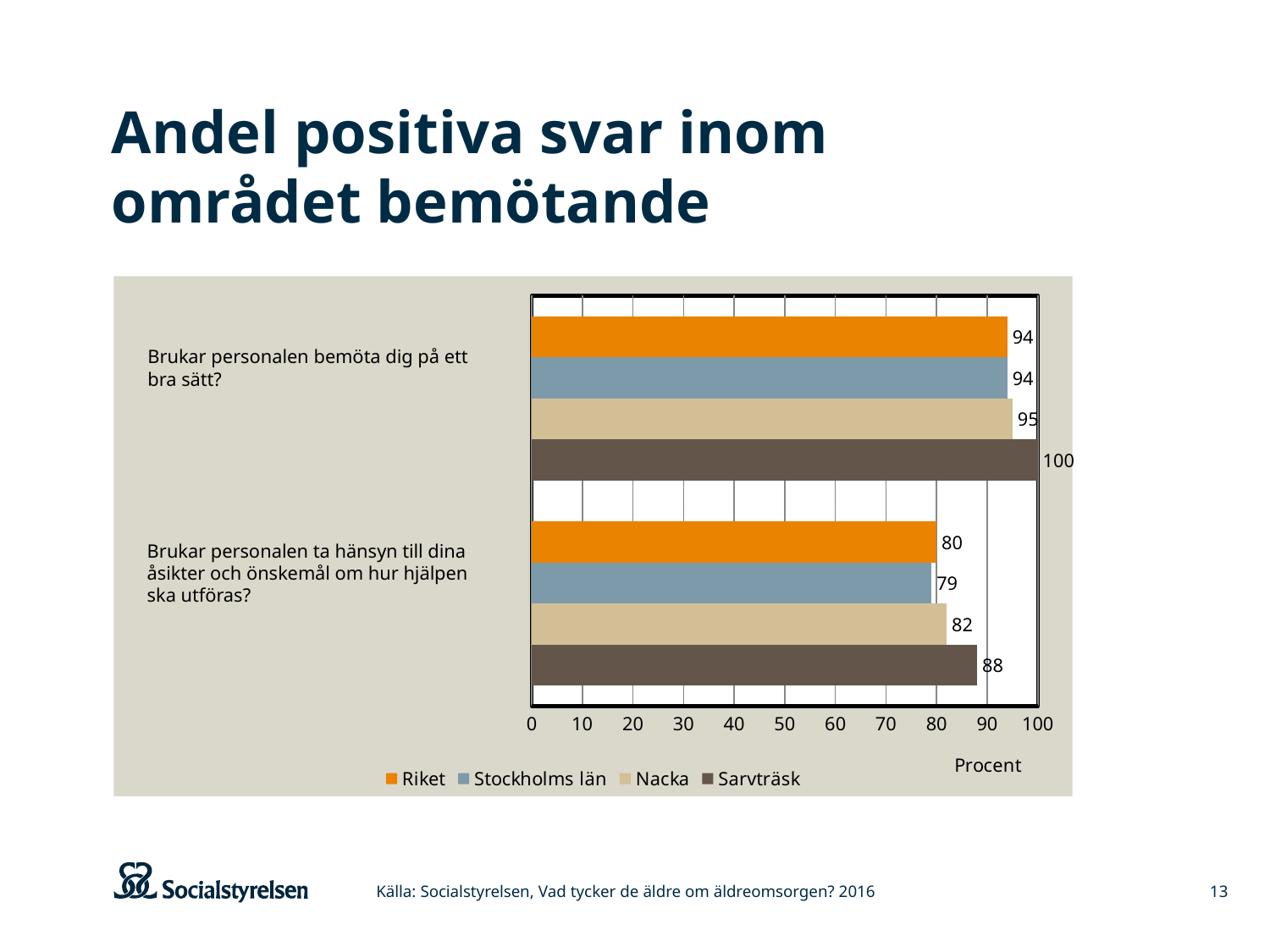
What is the value for Nacka on the question "Brukar personalen bemöta dig på ett bra sätt?"? 95 What is the value for Sarvträsk on the question "Brukar personalen bemöta dig på ett bra sätt?"? 100 Which series has the highest value on the question "Brukar personalen ta hänsyn till dina åsikter och önskemål om hur hjälpen ska utföras?"? Sarvträsk How many questions (categories) are shown on the chart? 2 What is the difference between the Sarvträsk value and the Riket value on the question "Brukar personalen ta hänsyn till dina åsikter och önskemål om hur hjälpen ska utföras?"? 8 What kind of chart is shown on the slide? Bar chart How many series does the legend list? 4 What is the label of the x axis? Procent Which series has the lowest value on the question "Brukar personalen ta hänsyn till dina åsikter och önskemål om hur hjälpen ska utföras?"? Stockholms län Which is larger: the Nacka value or the Riket value on the question "Brukar personalen ta hänsyn till dina åsikter och önskemål om hur hjälpen ska utföras?"? Nacka What is the value for Stockholms län on the question "Brukar personalen ta hänsyn till dina åsikter och önskemål om hur hjälpen ska utföras?"? 79 Which series is shown in orange in the legend? Riket